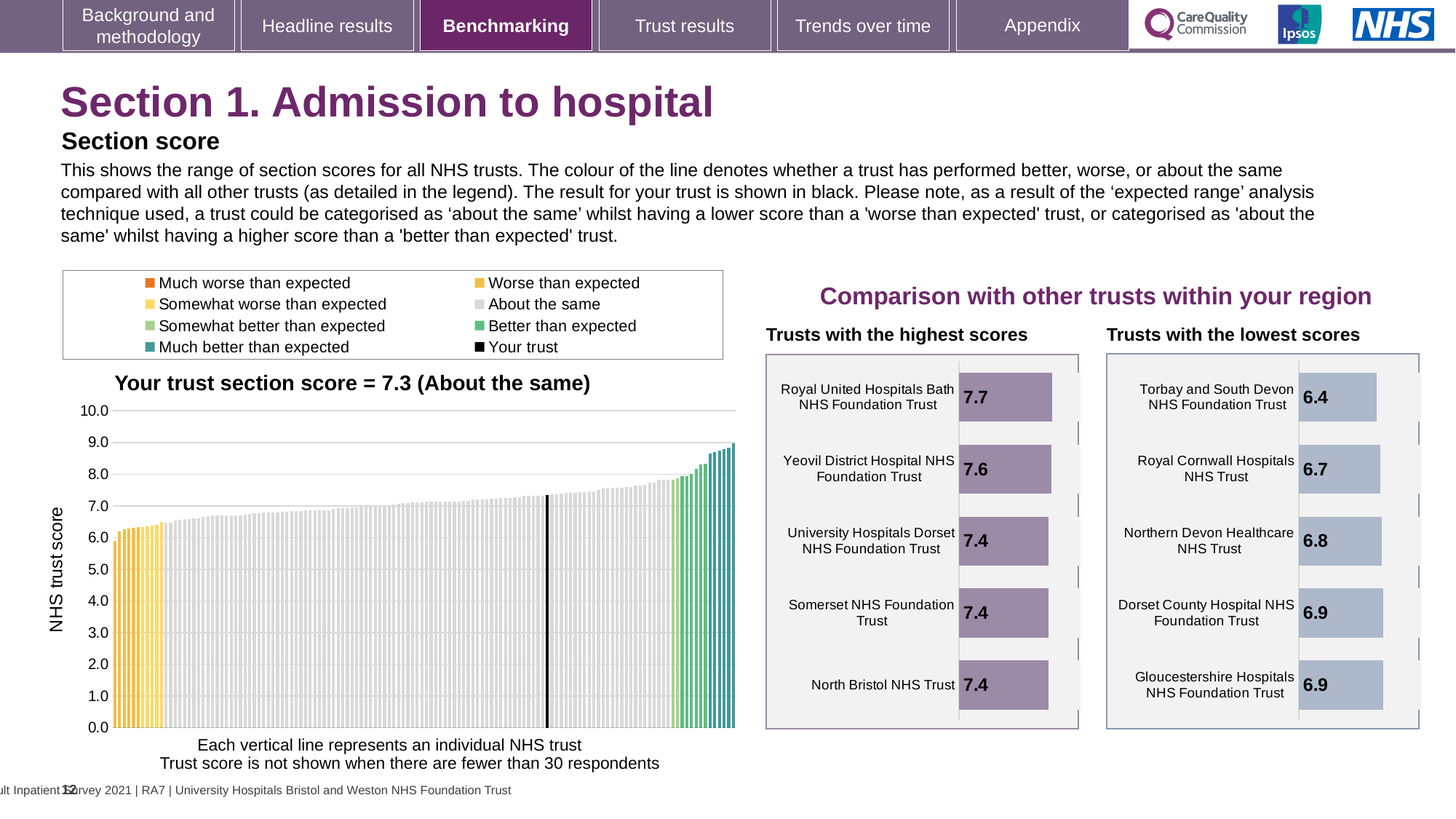
In the 'Trusts with the lowest scores' chart, which trust has the lowest score? Torbay and South Devon NHS Foundation Trust In the 'Your trust section score' chart, is the value of the shortest bar greater or less than 7.0? less In the 'Trusts with the highest scores' chart, what is the difference between the scores of Royal United Hospitals Bath NHS Foundation Trust and Yeovil District Hospital NHS Foundation Trust? 0.1 In the 'Trusts with the lowest scores' chart, which has the higher score: Royal Cornwall Hospitals NHS Trust or Northern Devon Healthcare NHS Trust? Northern Devon Healthcare NHS Trust In the 'Your trust section score' chart, what kind of chart is shown? Bar chart In the 'Your trust section score' chart, what is the section score for your trust? 7.3 In the 'Trusts with the highest scores' chart, what is the score for Royal United Hospitals Bath NHS Foundation Trust? 7.7 In the 'Your trust section score' chart, do the bars rise or fall from left to right? Rise In the 'Trusts with the highest scores' chart, how many trusts are shown? 5 In the 'Your trust section score' chart, what is the label on the vertical axis? NHS trust score In the 'Your trust section score' chart, is the value of the tallest bar greater or less than 8.0? greater How many entries does the legend above the 'Your trust section score' chart list? 8